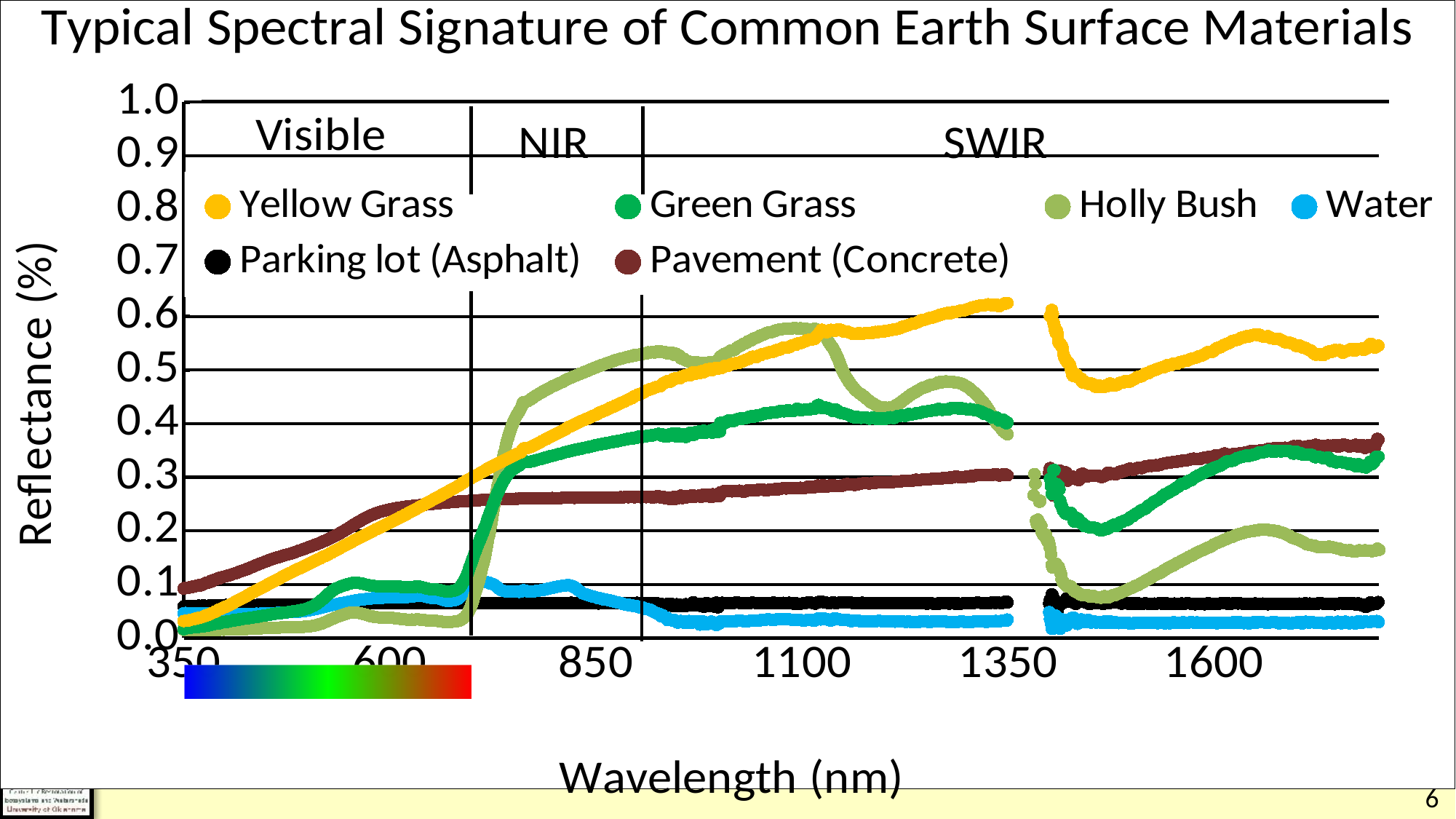
Does the reflectance of Yellow Grass rise or fall from 350 nm to 1350 nm? rise Is the reflectance of Water at 1100 nm greater or less than 0.1? less How many series does the legend list? 6 Which series has the highest reflectance at 1350 nm? Yellow Grass Is the reflectance of Holly Bush at 600 nm greater or less than 0.1? less Which series has the lowest reflectance at 1100 nm? Water Is the reflectance of Pavement (Concrete) at 850 nm greater or less than 0.2? greater At 850 nm, which has the higher reflectance, Holly Bush or Green Grass? Holly Bush What kind of chart is shown on the slide? line chart What is the title of the chart? Typical Spectral Signature of Common Earth Surface Materials